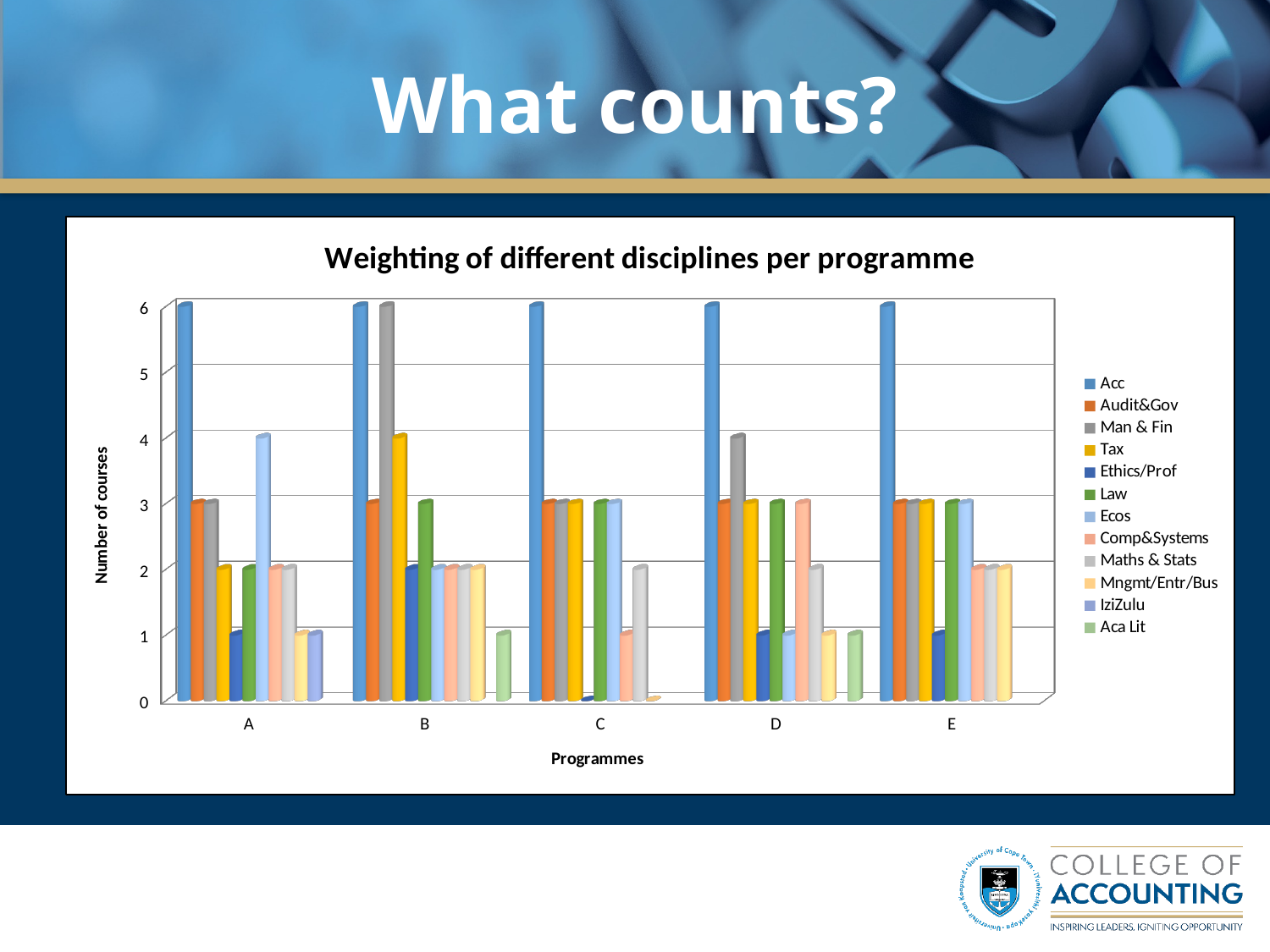
What is the label of the y axis? Number of courses Is the value for Man & Fin in programme D greater or less than 3? greater What type of chart is shown on the slide? bar chart What is the title of the chart? Weighting of different disciplines per programme How many series does the legend list? 12 What is the number of courses for Ecos in programme A? 4 What is the number of courses for Tax in programme B? 4 Is the number of courses for Tax larger in programme A or programme B? programme B What is the number of courses for Acc in programme A? 6 Which discipline has the highest number of courses in programme D? Acc What is the difference between the number of courses for Acc and for Ecos in programme A? 2 How many programmes are shown on the x axis? 5